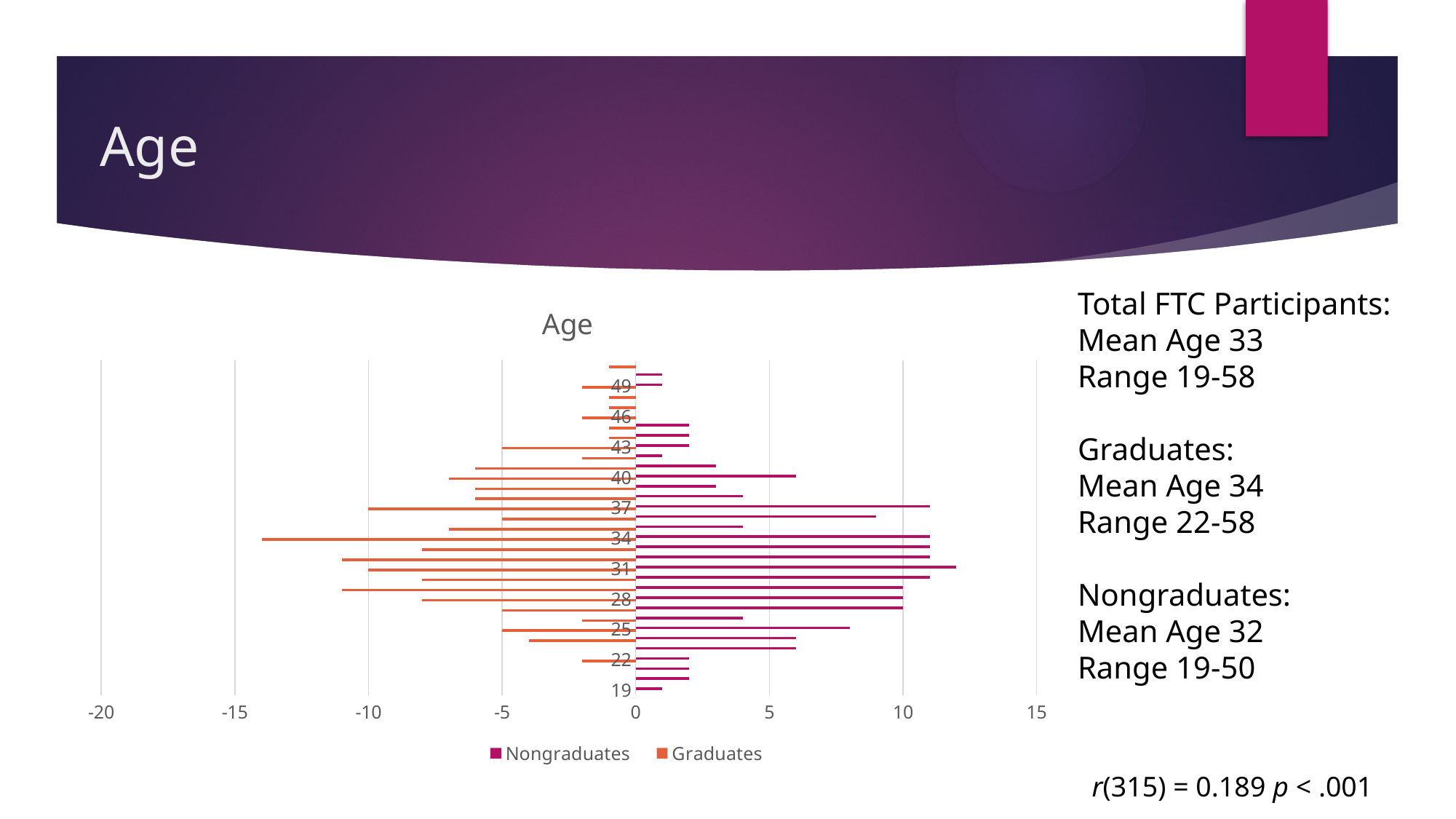
Is the value for Nongraduates at age 31 greater or less than 10? greater At which age label does the Graduates series have its longest bar? 34 Which series has the longest bar on the chart? Graduates What kind of chart is shown on the slide? bar chart Is the value for Nongraduates at age 19 greater or less than 5? less Is the value for Nongraduates at age 25 greater or less than 5? greater How many series does the chart legend list? 2 What is the title of the chart? Age What are the two series named in the chart legend? Nongraduates and Graduates What is the lowest value shown on the horizontal axis? -20